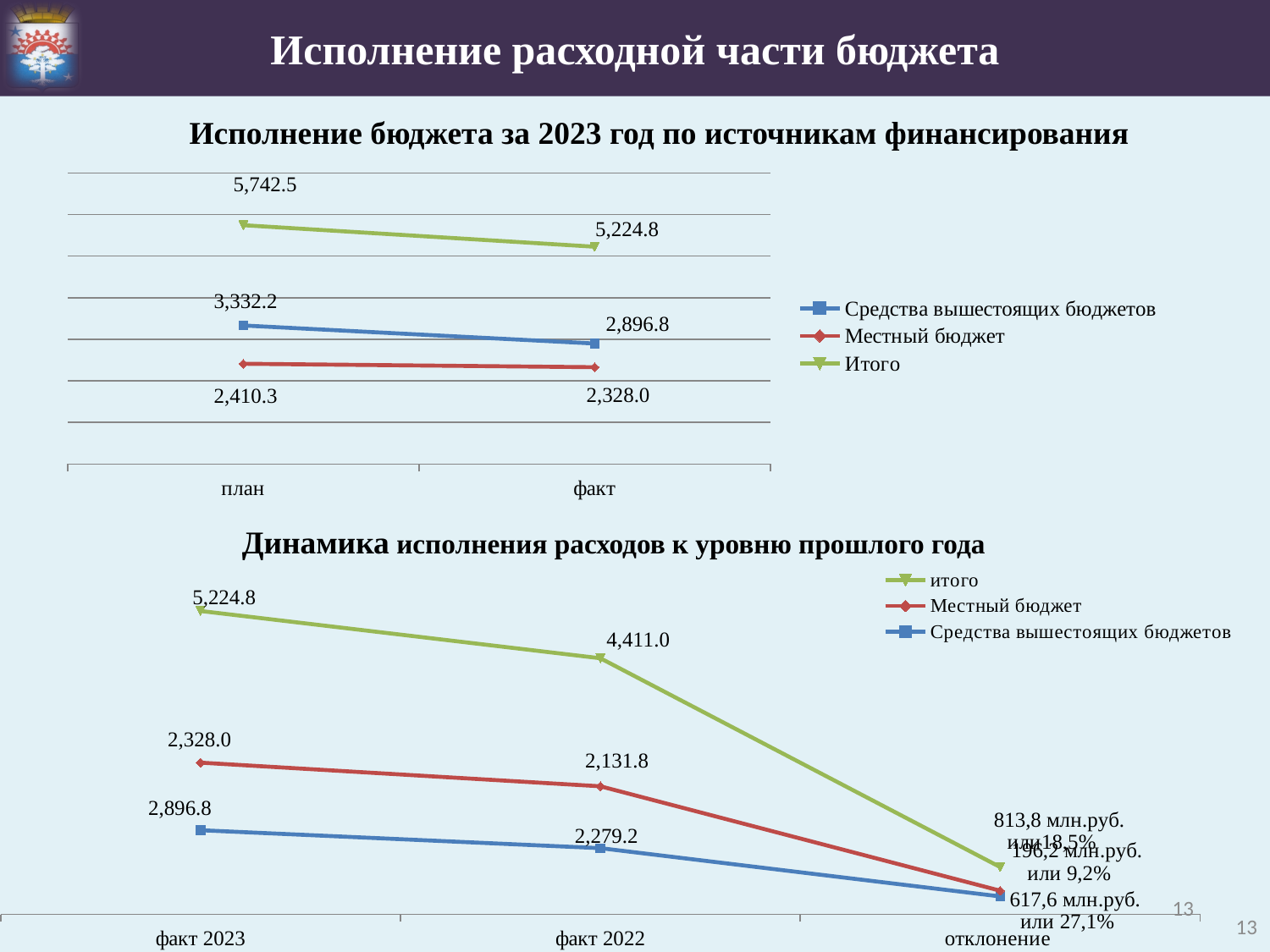
In the top chart 'Исполнение бюджета за 2023 год по источникам финансирования', what is the value of Местный бюджет for факт? 2,328.0 In the bottom chart 'Динамика исполнения расходов к уровню прошлого года', how many categories are shown on the x axis? 3 In the bottom chart 'Динамика исполнения расходов к уровню прошлого года', what is the difference between факт 2023 and факт 2022 for Местный бюджет? 196.2 What kind of chart is the bottom chart 'Динамика исполнения расходов к уровню прошлого года'? line chart In the top chart 'Исполнение бюджета за 2023 год по источникам финансирования', what is the difference between план and факт for Средства вышестоящих бюджетов? 435.4 In the bottom chart 'Динамика исполнения расходов к уровню прошлого года', what is the value of итого for факт 2022? 4,411.0 In the bottom chart 'Динамика исполнения расходов к уровню прошлого года', which is larger for факт 2023: итого or Местный бюджет? итого In the top chart 'Исполнение бюджета за 2023 год по источникам финансирования', how many series does the legend list? 3 In the top chart 'Исполнение бюджета за 2023 год по источникам финансирования', does the Итого series rise or fall from план to факт? fall In the top chart 'Исполнение бюджета за 2023 год по источникам финансирования', which series has the lowest value for план? Местный бюджет In the top chart 'Исполнение бюджета за 2023 год по источникам финансирования', what is the value of Итого for план? 5,742.5 In the bottom chart 'Динамика исполнения расходов к уровню прошлого года', what is the value of Средства вышестоящих бюджетов for факт 2022? 2,279.2